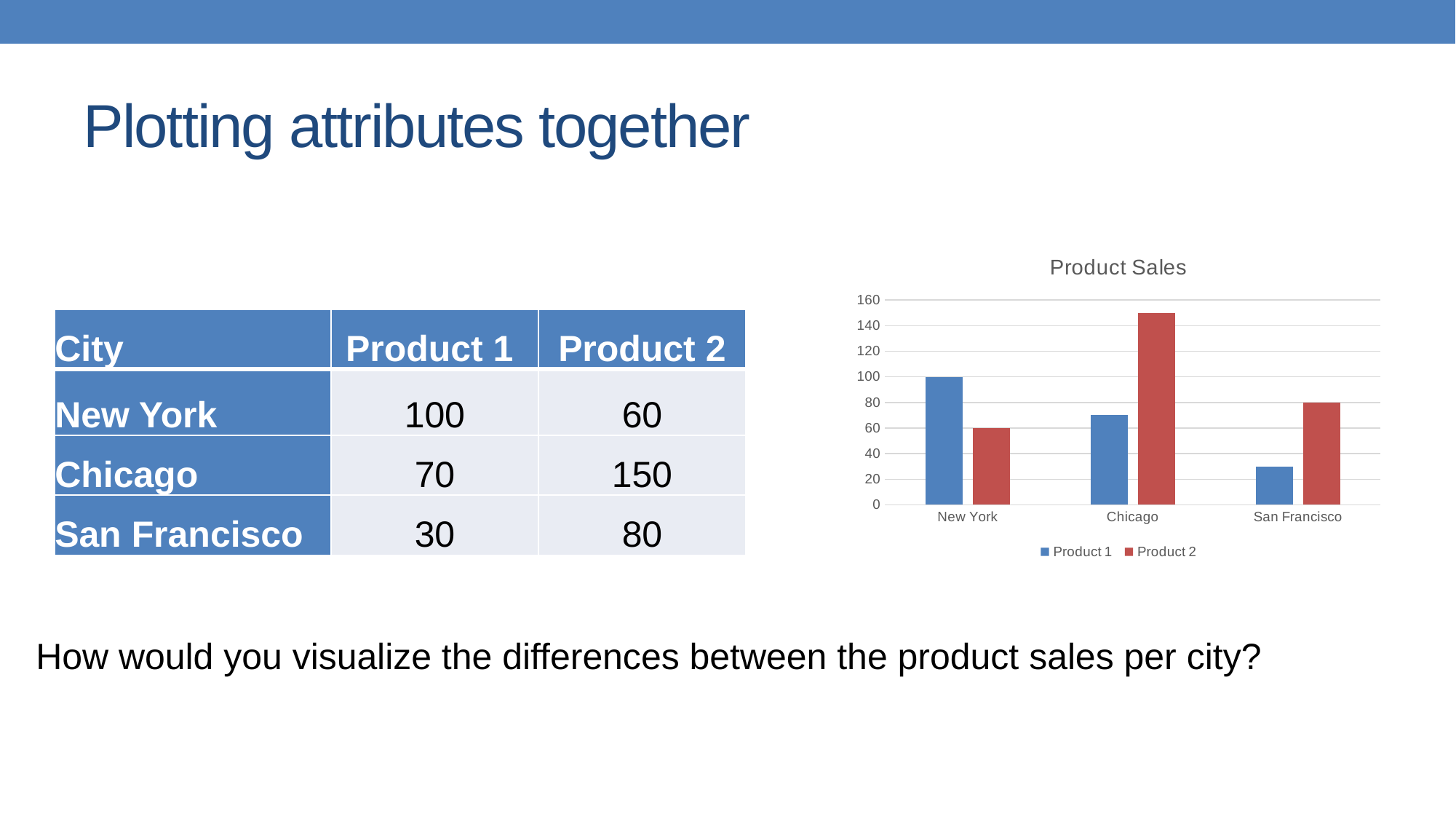
What is the Product 1 value for San Francisco? 30 Which city has the highest Product 2 value? Chicago For New York, which is larger, Product 1 or Product 2? Product 1 What is the Product 1 value for New York? 100 Is the Product 2 value for Chicago greater or less than 140? greater How many series does the chart legend list? 2 How many cities are shown on the x axis of the chart? 3 What is the Product 2 value for Chicago? 150 What type of chart is shown on the slide? bar chart What is the difference between Product 2 and Product 1 for Chicago? 80 Which city has the lowest Product 1 value? San Francisco What is the title of the chart? Product Sales